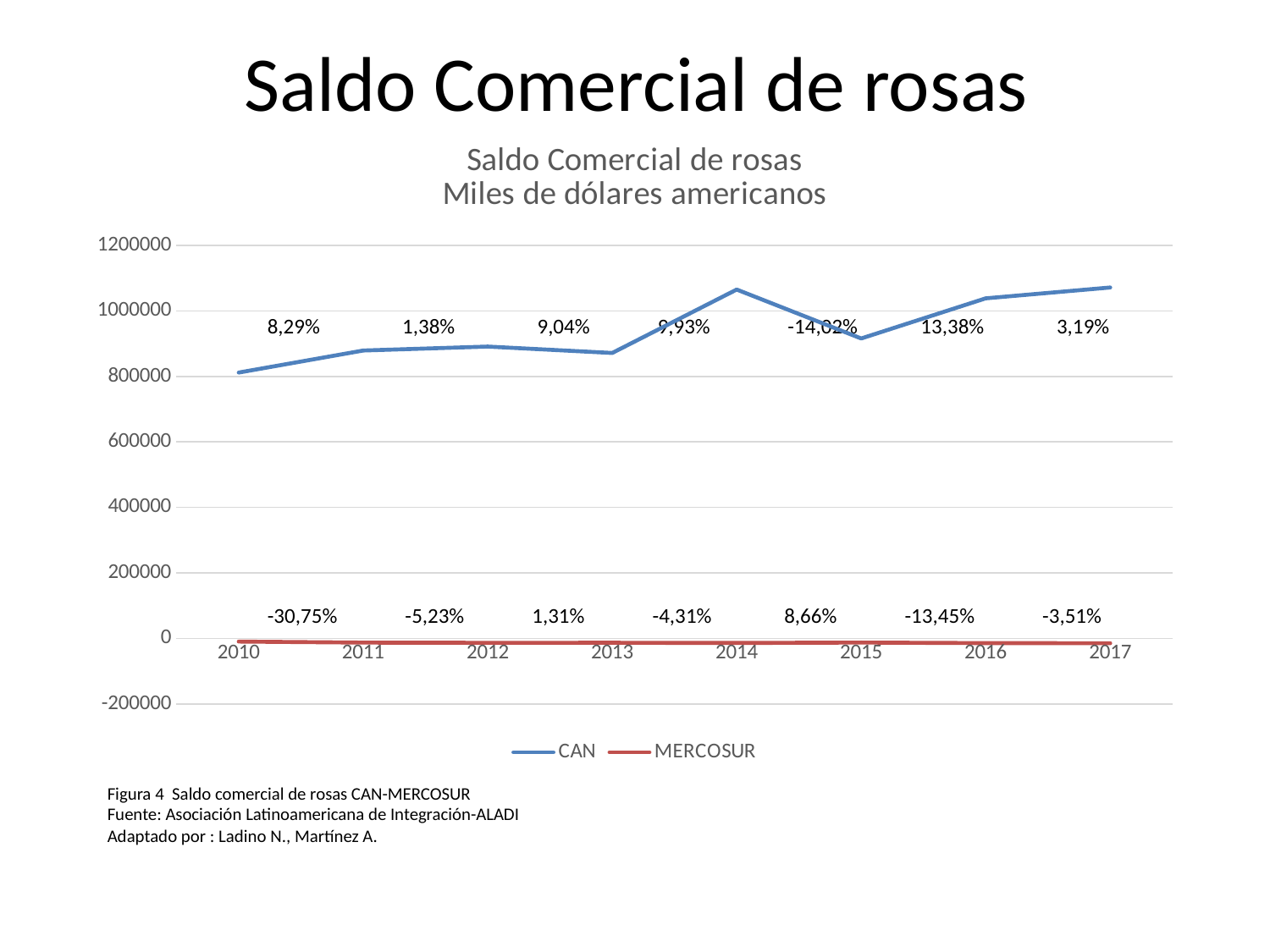
Is the CAN value for 2015 greater or less than 1000000? less Which is larger, the CAN value for 2014 or the CAN value for 2015? 2014 Is the CAN value for 2010 greater or less than 1000000? less Does the CAN line rise or fall between 2010 and 2011? rise In which year is the CAN value lowest? 2010 How many series does the legend list? 2 Is the MERCOSUR value for 2013 greater or less than 200000? less How many years are plotted along the x axis? 8 Which series has the higher value in 2016, CAN or MERCOSUR? CAN What percentage label is shown above the CAN line at 2016? 13,38% What type of chart is shown on the slide? line chart